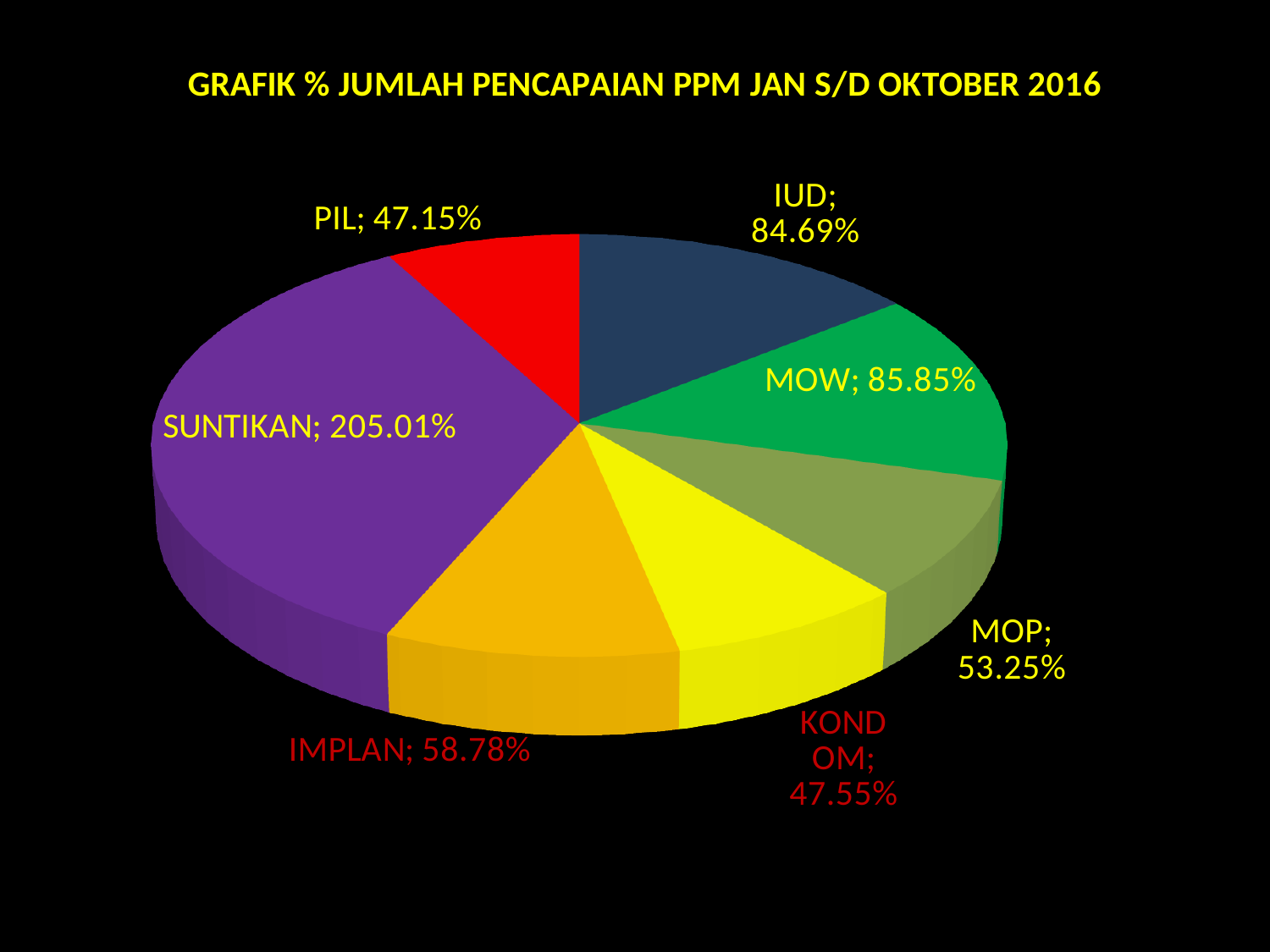
What kind of chart is shown on the slide? Pie chart What is the difference between the values for SUNTIKAN and IUD? 120.32% How many categories are shown in the pie chart? 7 What is the value shown for IUD? 84.69% What colour is the SUNTIKAN slice? Purple What is the difference between the values for IMPLAN and MOP? 5.53% Which category has the lowest value? PIL What is the value shown for MOP? 53.25% Which has the larger value, MOW or IUD? MOW What is the value shown for SUNTIKAN? 205.01% What is the value shown for KONDOM? 47.55% Which category has the highest value? SUNTIKAN